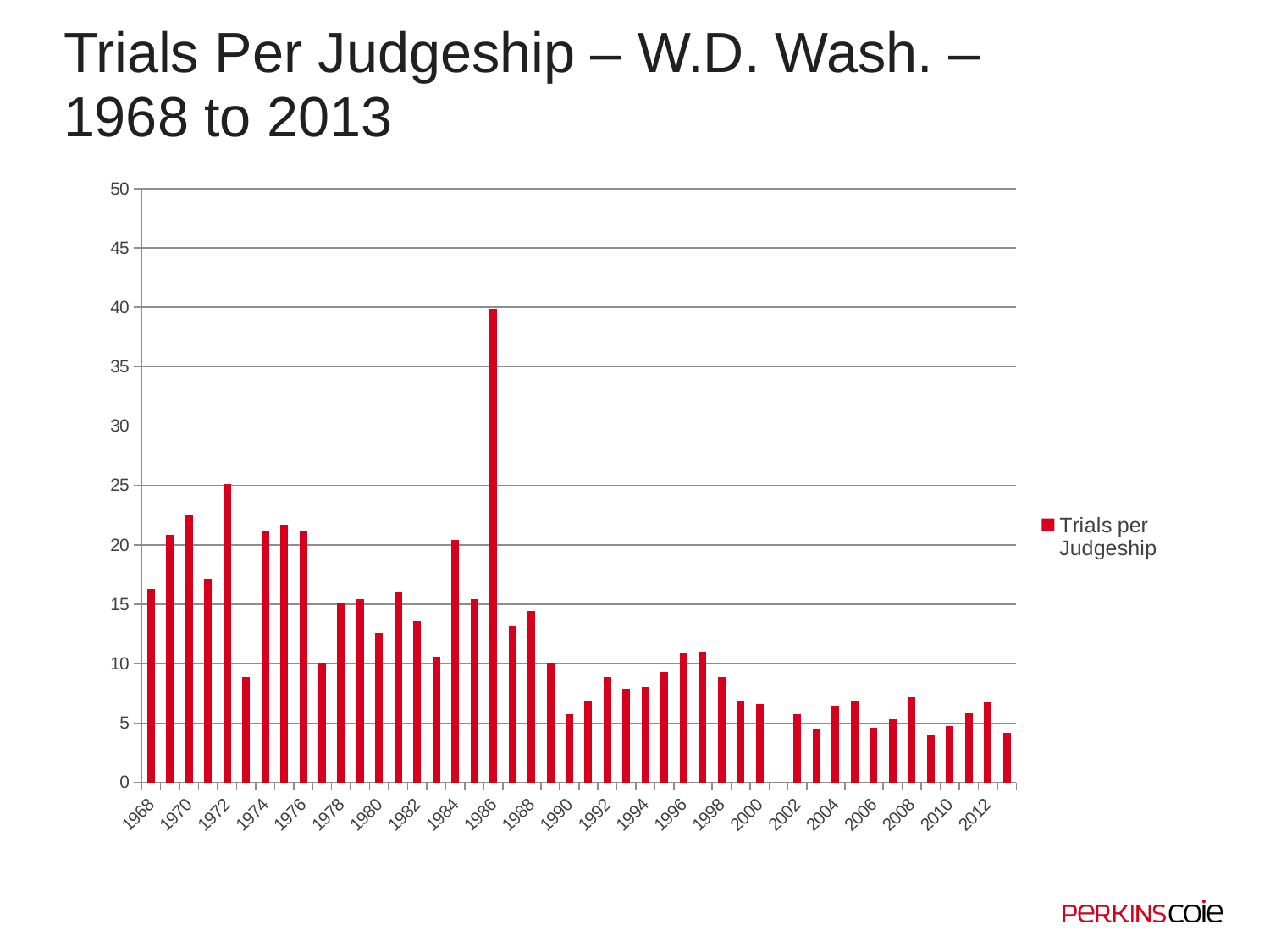
Is the value for 1973 greater or less than 10? less What kind of chart is shown on the slide? bar chart Which year has the larger value, 1970 or 1972? 1972 How many series does the legend list? 1 Which year has the larger value, 1984 or 1988? 1984 Is the value for 2013 greater or less than 5? less What is the name of the series shown in the legend? Trials per Judgeship Which year has the highest number of trials per judgeship? 1986 Is the value for 1972 greater or less than 20? greater What is the highest value shown on the y axis? 50 Overall, do the values rise or fall from 1968 to 2013? fall